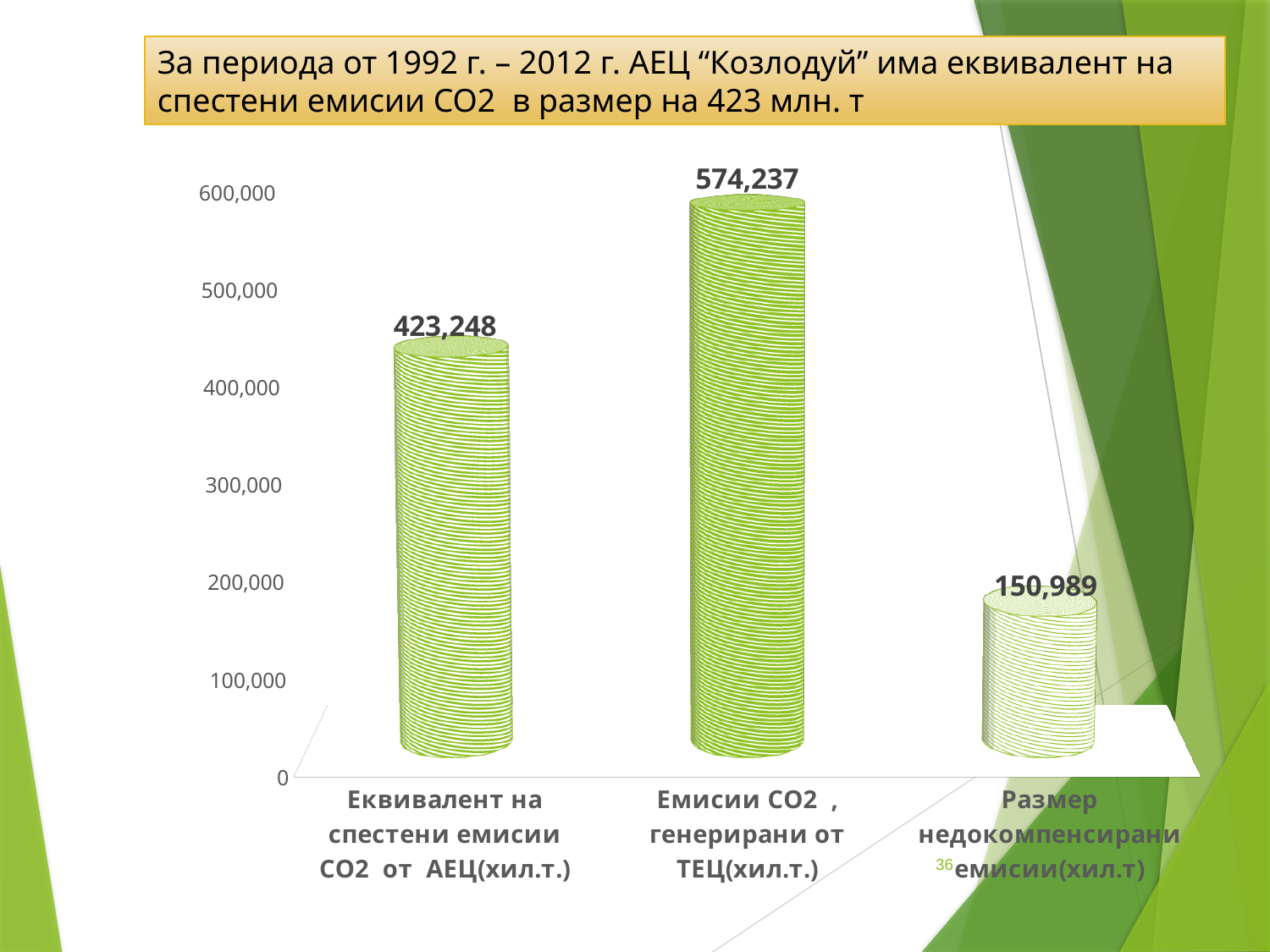
Which category has the highest value? Емисии CO2, генерирани от ТЕЦ(хил.т.) What is the value for "Еквивалент на спестени емисии CO2 от АЕЦ(хил.т.)"? 423,248 Is the value for "Емисии CO2, генерирани от ТЕЦ(хил.т.)" greater or less than 500,000? greater How many categories are shown in the chart? 3 What kind of chart is shown on the slide? bar chart What is the value for "Размер недокомпенсирани емисии(хил.т)"? 150,989 What is the value for "Емисии CO2, генерирани от ТЕЦ(хил.т.)"? 574,237 Is the value for "Размер недокомпенсирани емисии(хил.т)" greater or less than 200,000? less Which is larger: the value for "Еквивалент на спестени емисии CO2 от АЕЦ(хил.т.)" or the value for "Размер недокомпенсирани емисии(хил.т)"? Еквивалент на спестени емисии CO2 от АЕЦ(хил.т.) What is the difference between the value for "Еквивалент на спестени емисии CO2 от АЕЦ(хил.т.)" and the value for "Размер недокомпенсирани емисии(хил.т)"? 272,259 What is the difference between the value for "Емисии CO2, генерирани от ТЕЦ(хил.т.)" and the value for "Еквивалент на спестени емисии CO2 от АЕЦ(хил.т.)"? 150,989 Which category has the lowest value? Размер недокомпенсирани емисии(хил.т)